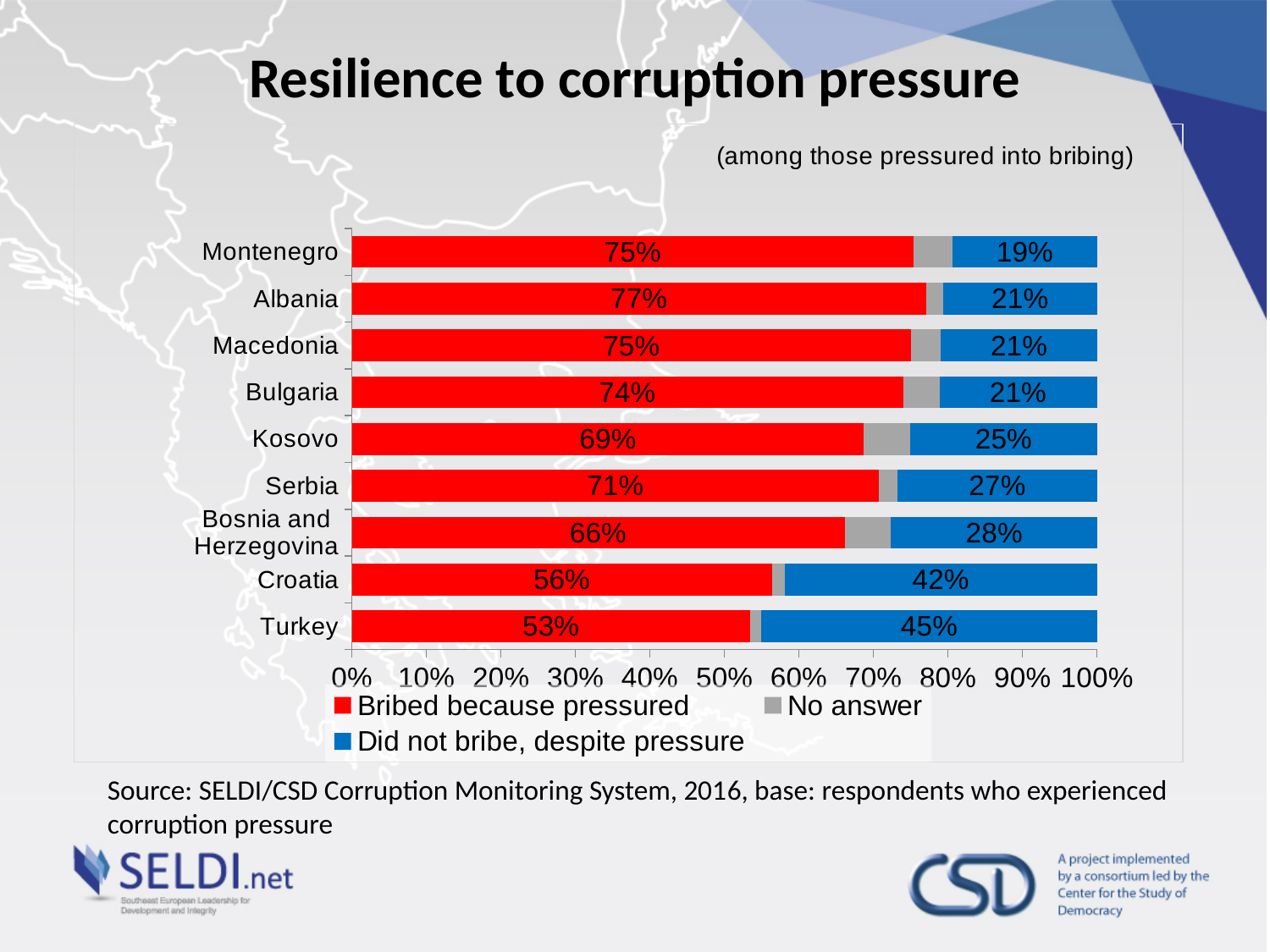
Which is larger: the 'Did not bribe, despite pressure' value for Kosovo or for Serbia? Serbia How many countries are shown in the chart? 9 What kind of chart is shown on the slide? Stacked bar chart Which country has the highest share of respondents who bribed because pressured? Albania Which country has the lowest share of respondents who bribed because pressured? Turkey Which series is shown in grey in the chart? No answer Which country has the lowest share of respondents who did not bribe, despite pressure? Montenegro What percentage of respondents in Albania bribed because pressured? 77% What is the difference between the 'Bribed because pressured' values for Croatia and Turkey? 3% What is the value for 'Bribed because pressured' in Bosnia and Herzegovina? 66% How many series does the legend list? 3 What percentage of respondents in Turkey did not bribe, despite pressure? 45%